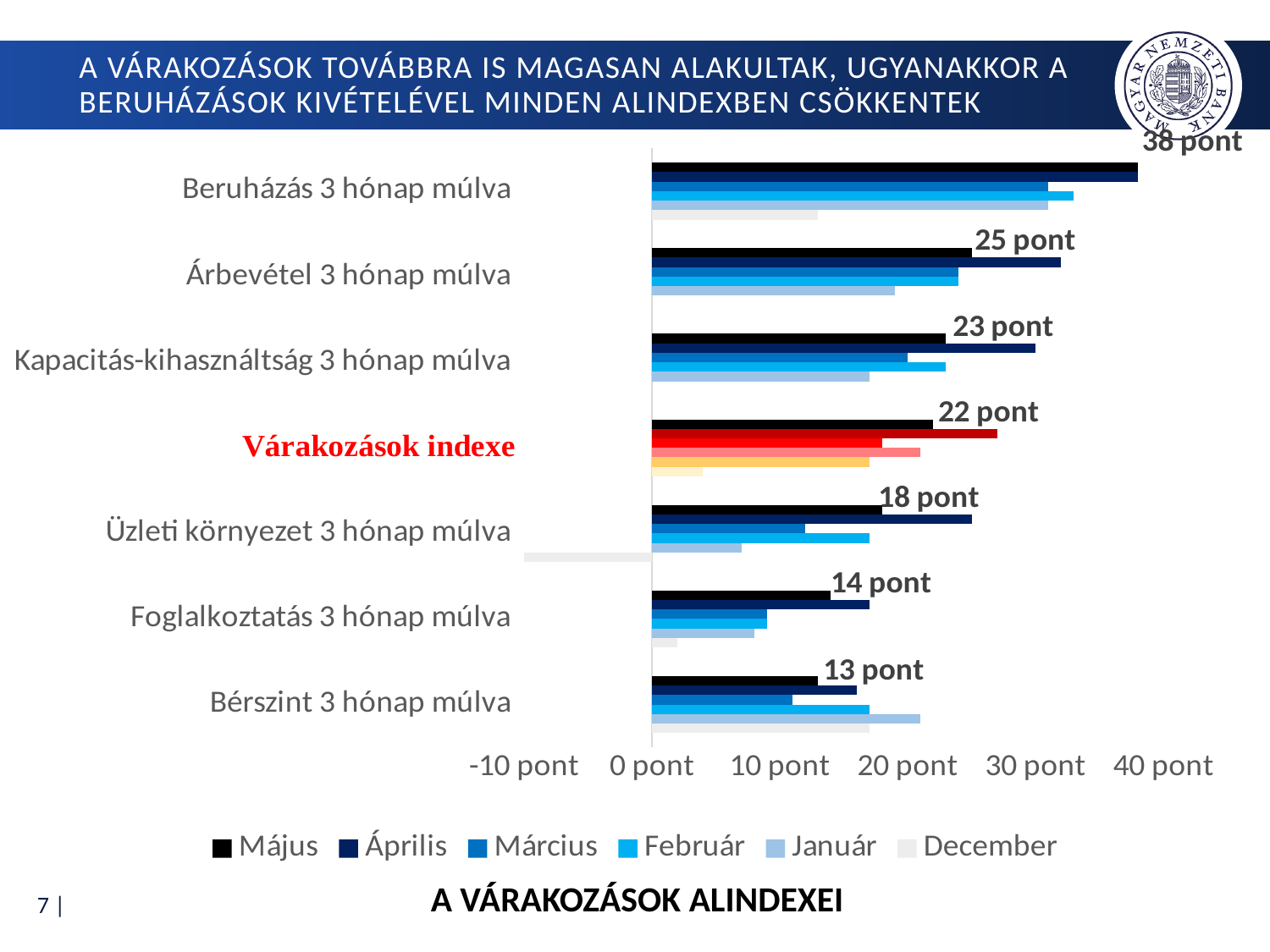
What is the difference between the Május values for Beruházás 3 hónap múlva and Bérszint 3 hónap múlva? 25 pont What kind of chart is shown on the slide? bar chart How many categories are shown on the chart? 7 What is the Május value for Beruházás 3 hónap múlva? 38 pont What is the Május value for Várakozások indexe? 22 pont Which has the larger Május value: Kapacitás-kihasználtság 3 hónap múlva or Üzleti környezet 3 hónap múlva? Kapacitás-kihasználtság 3 hónap múlva Is the Január value for Bérszint 3 hónap múlva greater or less than 20 pont? greater Is the December value for Üzleti környezet 3 hónap múlva greater or less than 0 pont? less Which category has the highest Május value? Beruházás 3 hónap múlva Which category has the lowest Május value? Bérszint 3 hónap múlva How many series does the legend list? 6 What is the Május value for Bérszint 3 hónap múlva? 13 pont